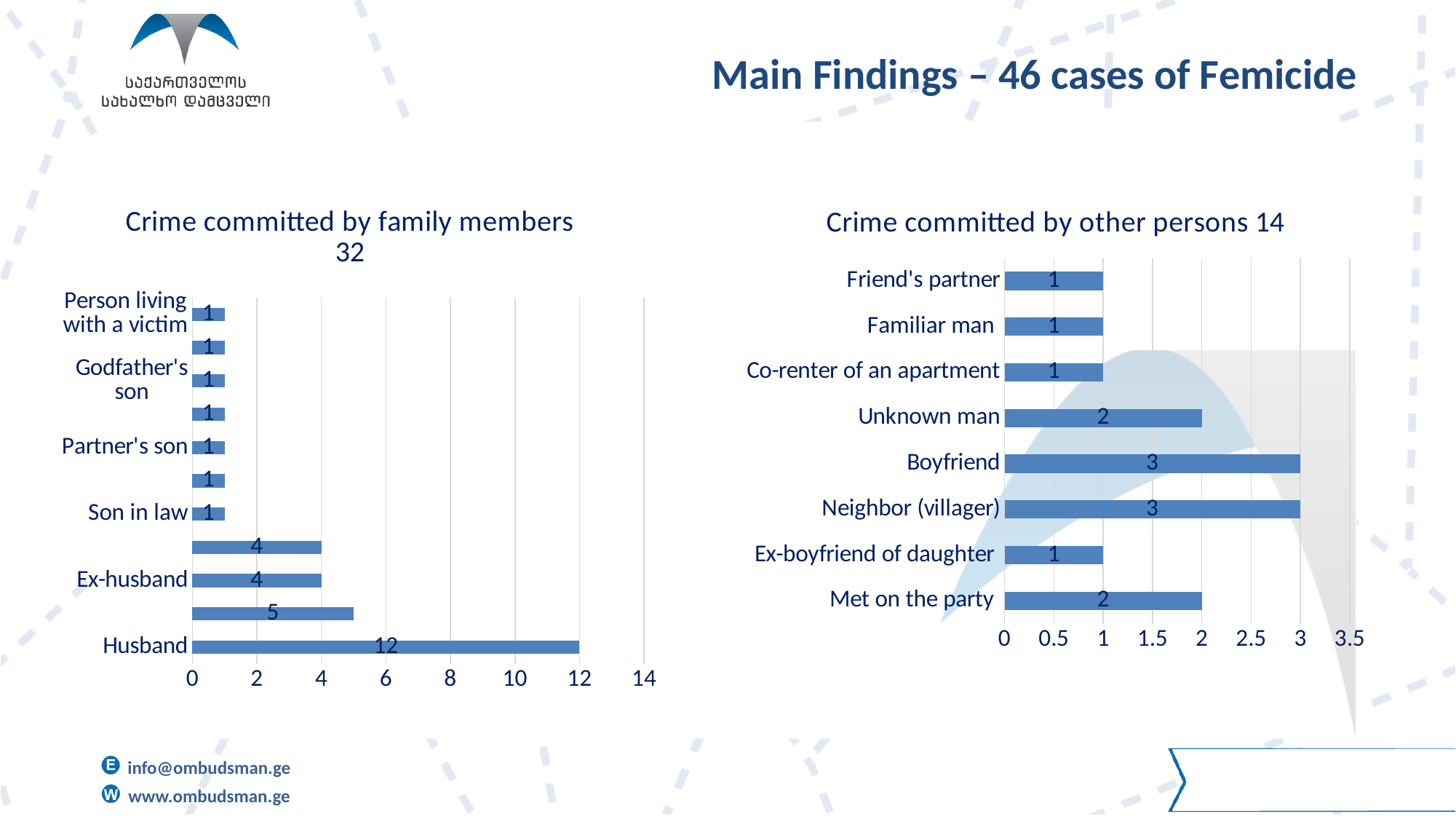
In the 'Crime committed by other persons 14' chart, what is the value for Unknown man? 2 In the 'Crime committed by family members 32' chart, what is the value for Ex-husband? 4 In the 'Crime committed by family members 32' chart, which category has the highest value? Husband What kind of chart is the 'Crime committed by other persons 14' chart? Bar chart In the 'Crime committed by family members 32' chart, what is the difference between the values for Husband and Ex-husband? 8 In the 'Crime committed by other persons 14' chart, what is the difference between the values for Boyfriend and Met on the party? 1 In the 'Crime committed by other persons 14' chart, how many categories are shown? 8 In the 'Crime committed by other persons 14' chart, what is the value for Boyfriend? 3 In the 'Crime committed by family members 32' chart, is the value for Husband greater or less than 10? greater In the 'Crime committed by family members 32' chart, what is the value for Husband? 12 What is the title of the chart on the left side of the slide? Crime committed by family members 32 In the 'Crime committed by other persons 14' chart, which is larger, the value for Neighbor (villager) or the value for Ex-boyfriend of daughter? Neighbor (villager)